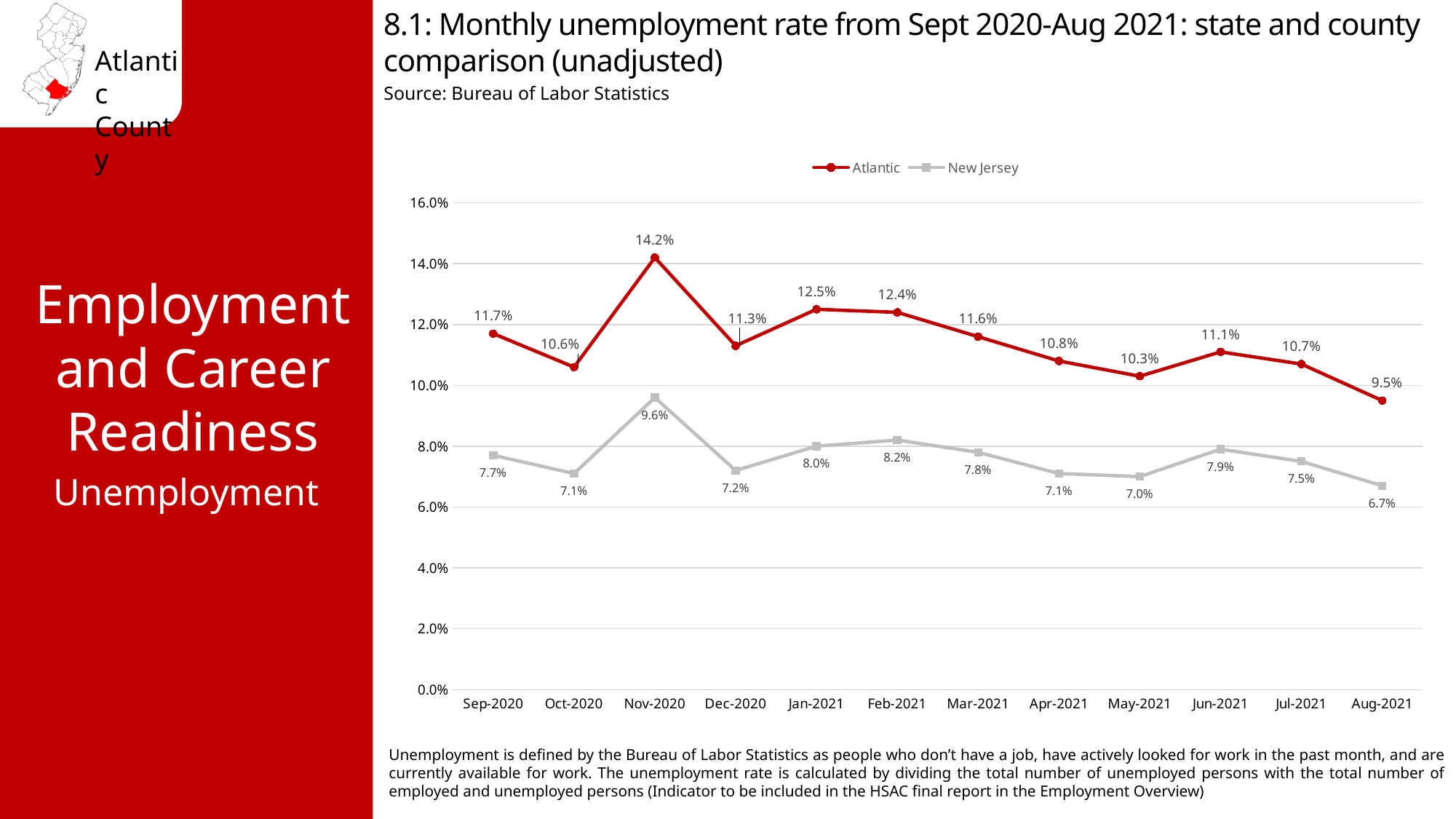
How many months are shown on the x axis? 12 What was the unemployment rate for Atlantic in Jan-2021? 12.5% In which month did Atlantic have its highest unemployment rate? Nov-2020 From Jan-2021 to May-2021, did the Atlantic unemployment rate rise or fall? Fall Which had the higher unemployment rate in Feb-2021, Atlantic or New Jersey? Atlantic How many series does the legend list? 2 What is the source cited for the chart? Bureau of Labor Statistics What was the unemployment rate for New Jersey in Aug-2021? 6.7% What was the unemployment rate for Atlantic in Nov-2020? 14.2% What kind of chart is shown on the slide? Line chart In which month did New Jersey have its lowest unemployment rate? Aug-2021 What is the difference between the Atlantic and New Jersey unemployment rates in Nov-2020? 4.6%